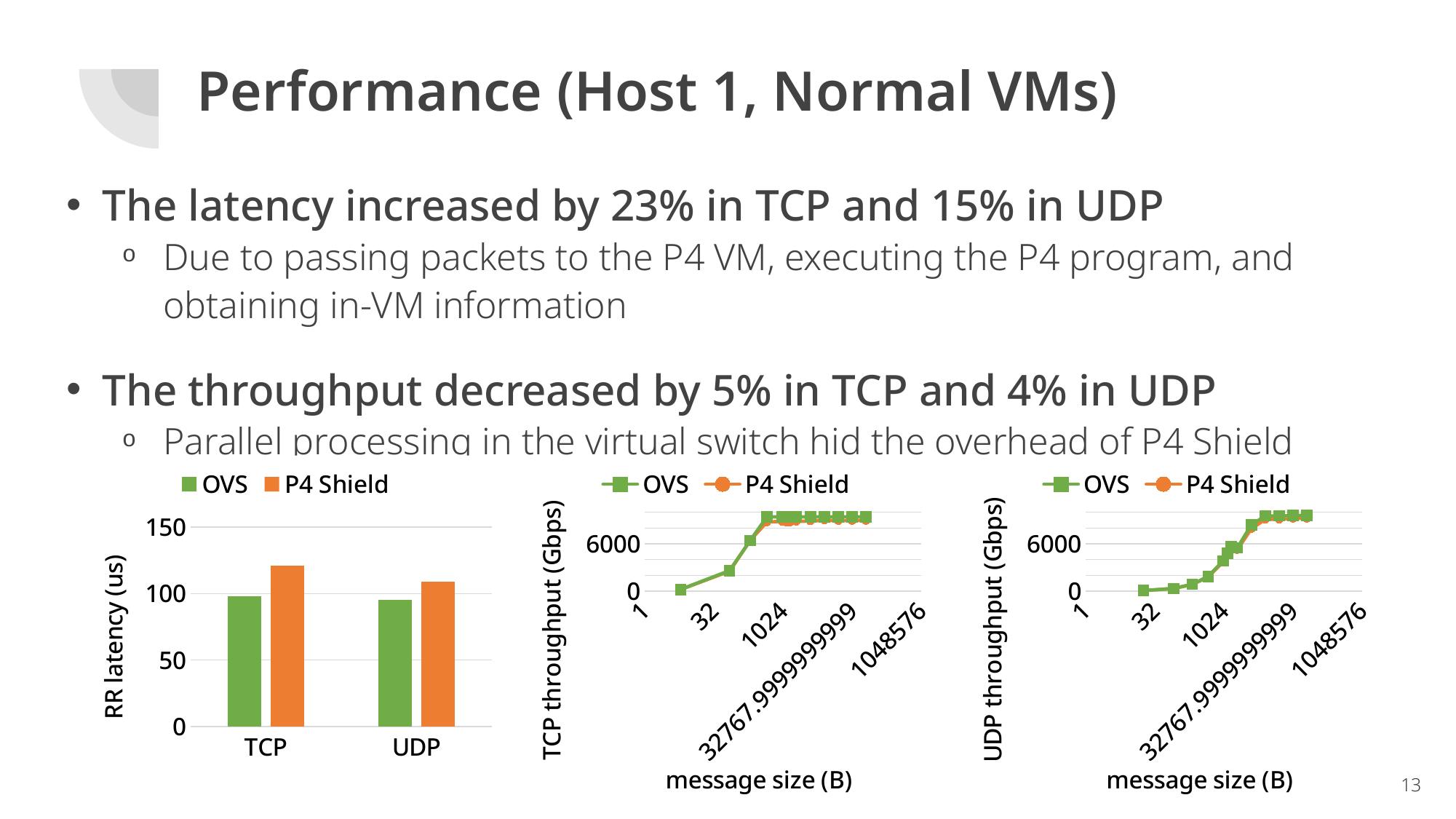
In the RR latency chart, is the OVS value for UDP greater or less than 100? less What is the x-axis label of the UDP throughput chart on the right? message size (B) What kind of chart is the RR latency chart on the left of the slide? bar chart What kind of chart is the TCP throughput chart in the middle of the slide? line chart In the RR latency chart, which is larger for UDP: OVS or P4 Shield? P4 Shield In the RR latency chart, how many series does the legend list? 2 In the UDP throughput chart on the right, do the values rise or fall as message size increases? rise In the RR latency chart, which bar is the highest? P4 Shield for TCP In the RR latency chart, which is larger for TCP: OVS or P4 Shield? P4 Shield In the RR latency chart, is the P4 Shield value for TCP greater or less than 100? greater In the RR latency chart, how many categories are shown on the x axis? 2